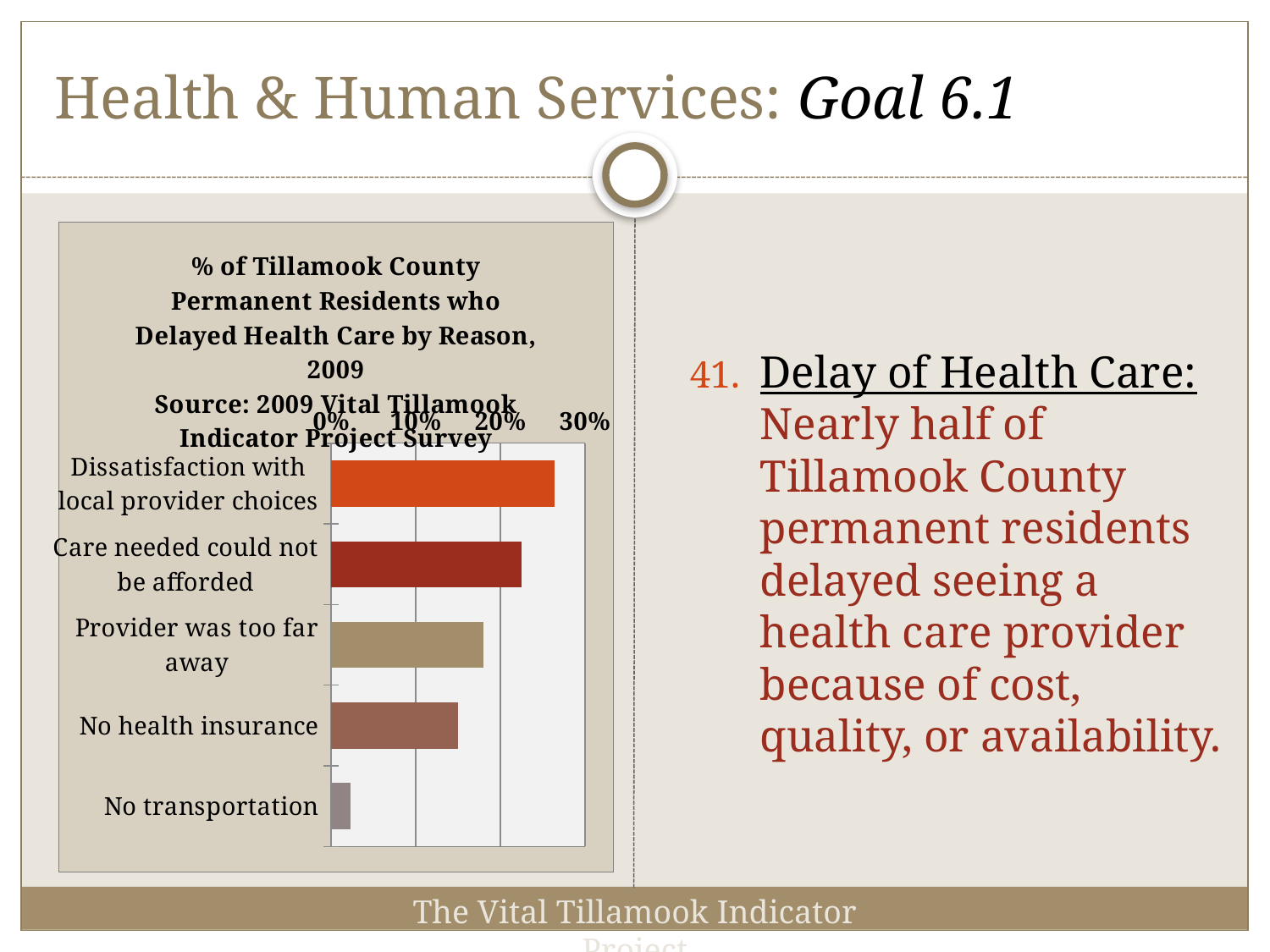
According to the chart title, what is the source of the data? 2009 Vital Tillamook Indicator Project Survey What kind of chart is shown on the slide? bar chart Which reason has the highest percentage in the chart? Dissatisfaction with local provider choices Is the value for 'No health insurance' greater or less than 20%? less Is the value for 'Dissatisfaction with local provider choices' greater or less than 20%? greater Is the value for 'Care needed could not be afforded' greater or less than 30%? less How many reasons for delaying health care are listed in the chart? 5 Which is larger: the value for 'Dissatisfaction with local provider choices' or the value for 'No health insurance'? Dissatisfaction with local provider choices Which is larger: the value for 'Care needed could not be afforded' or the value for 'Provider was too far away'? Care needed could not be afforded Which reason has the lowest percentage in the chart? No transportation